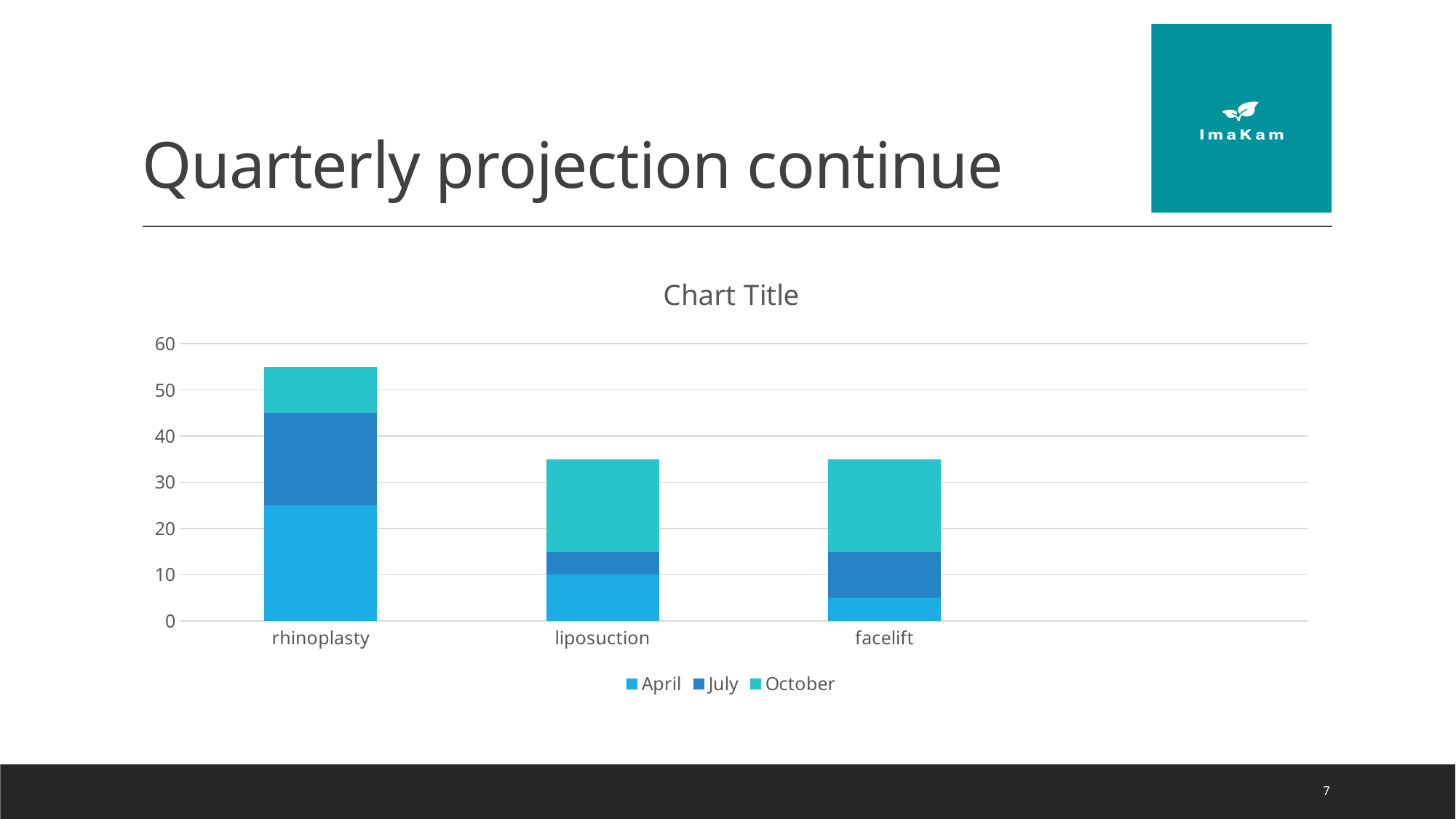
Which series are listed in the chart's legend? April, July, October What kind of chart is shown on the slide? Stacked bar chart Which category has the tallest stacked bar in the chart? rhinoplasty Is the total height of the rhinoplasty bar greater or less than 50? greater How many categories are shown on the x axis of the chart? 3 What is the title shown above the chart? Chart Title Is the April value for rhinoplasty greater or less than 20? greater Is the April value for facelift greater or less than 10? less How many series does the chart's legend list? 3 Which stacked bar is taller, rhinoplasty or liposuction? rhinoplasty